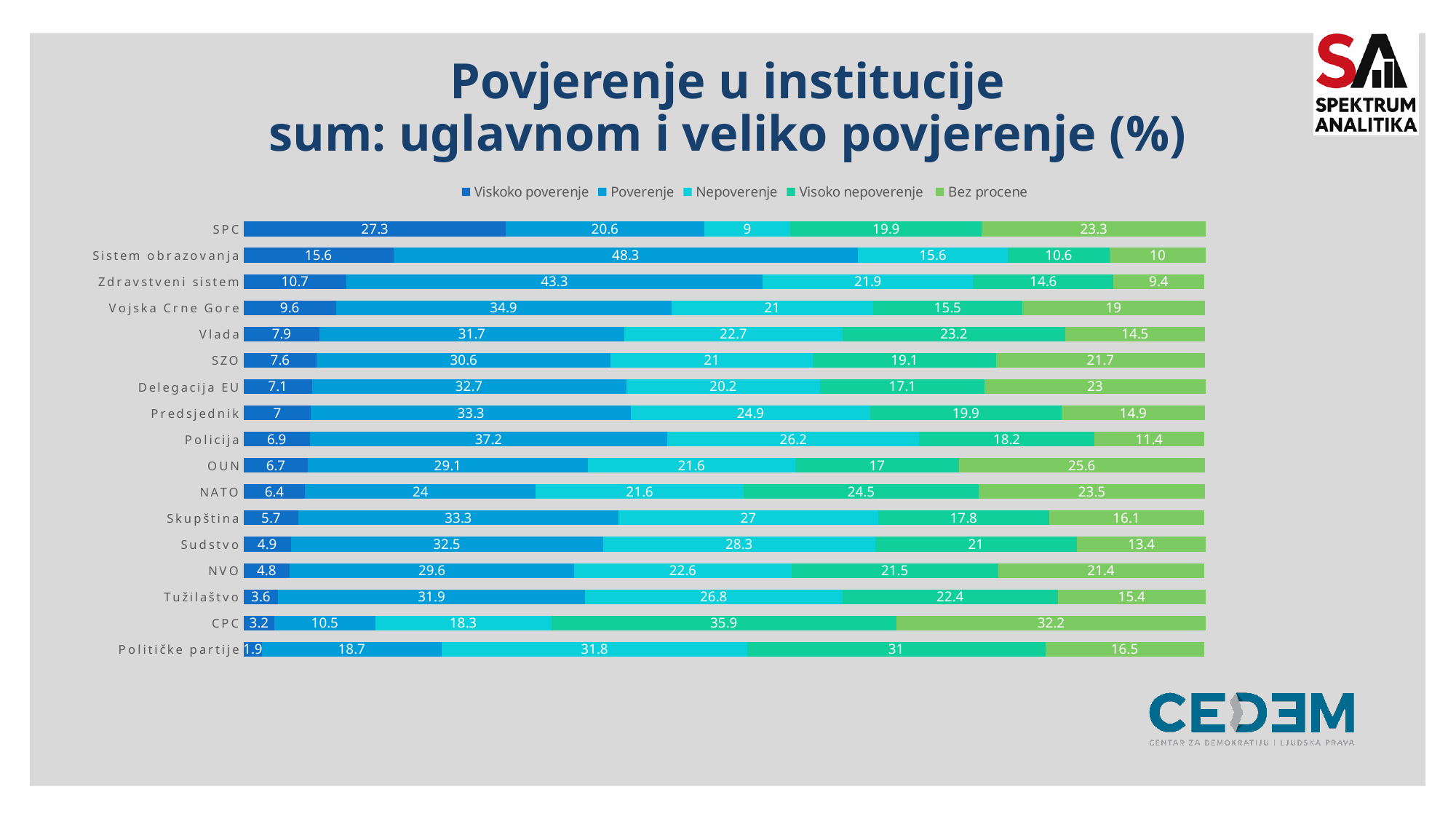
What is the difference between the 'Viskoko poverenje' values for SPC and Sistem obrazovanja? 11.7 What is the 'Viskoko poverenje' value for SPC? 27.3 How many series does the legend list? 5 What is the 'Visoko nepoverenje' value for CPC? 35.9 Which has a larger 'Visoko nepoverenje' value, Vlada or SZO? Vlada Which institution has the highest 'Viskoko poverenje' value? SPC What is the 'Bez procene' value for OUN? 25.6 Which institution has the highest 'Poverenje' value? Sistem obrazovanja What kind of chart is shown on the slide? Stacked bar chart What is the 'Poverenje' value for Sistem obrazovanja? 48.3 How many institutions are shown in the chart? 17 Which institution has the lowest 'Viskoko poverenje' value? Političke partije